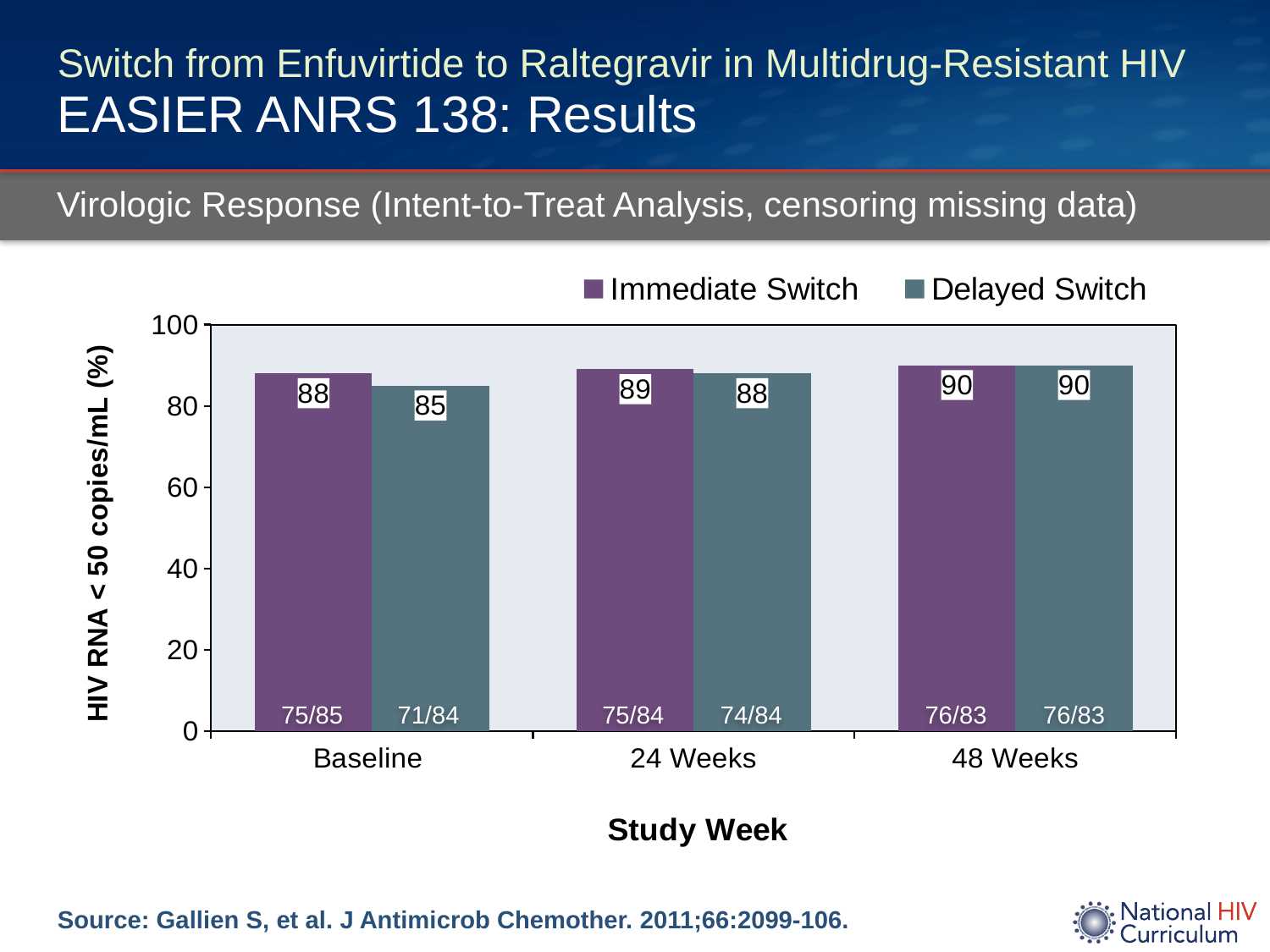
What is the value for Immediate Switch at Baseline? 88 Does the Delayed Switch value rise or fall from Baseline to 48 Weeks? Rise At which study week is the Delayed Switch value lowest? Baseline What is the value for Delayed Switch at 24 Weeks? 88 How many series does the legend list? 2 What kind of chart is shown? Bar chart What is the difference between the Immediate Switch and Delayed Switch values at Baseline? 3 How many study week categories are shown on the x axis? 3 Which is larger at Baseline, Immediate Switch or Delayed Switch? Immediate Switch What is the value for Immediate Switch at 48 Weeks? 90 What is the difference between the Immediate Switch value at 48 Weeks and at Baseline? 2 What is the value for Delayed Switch at Baseline? 85